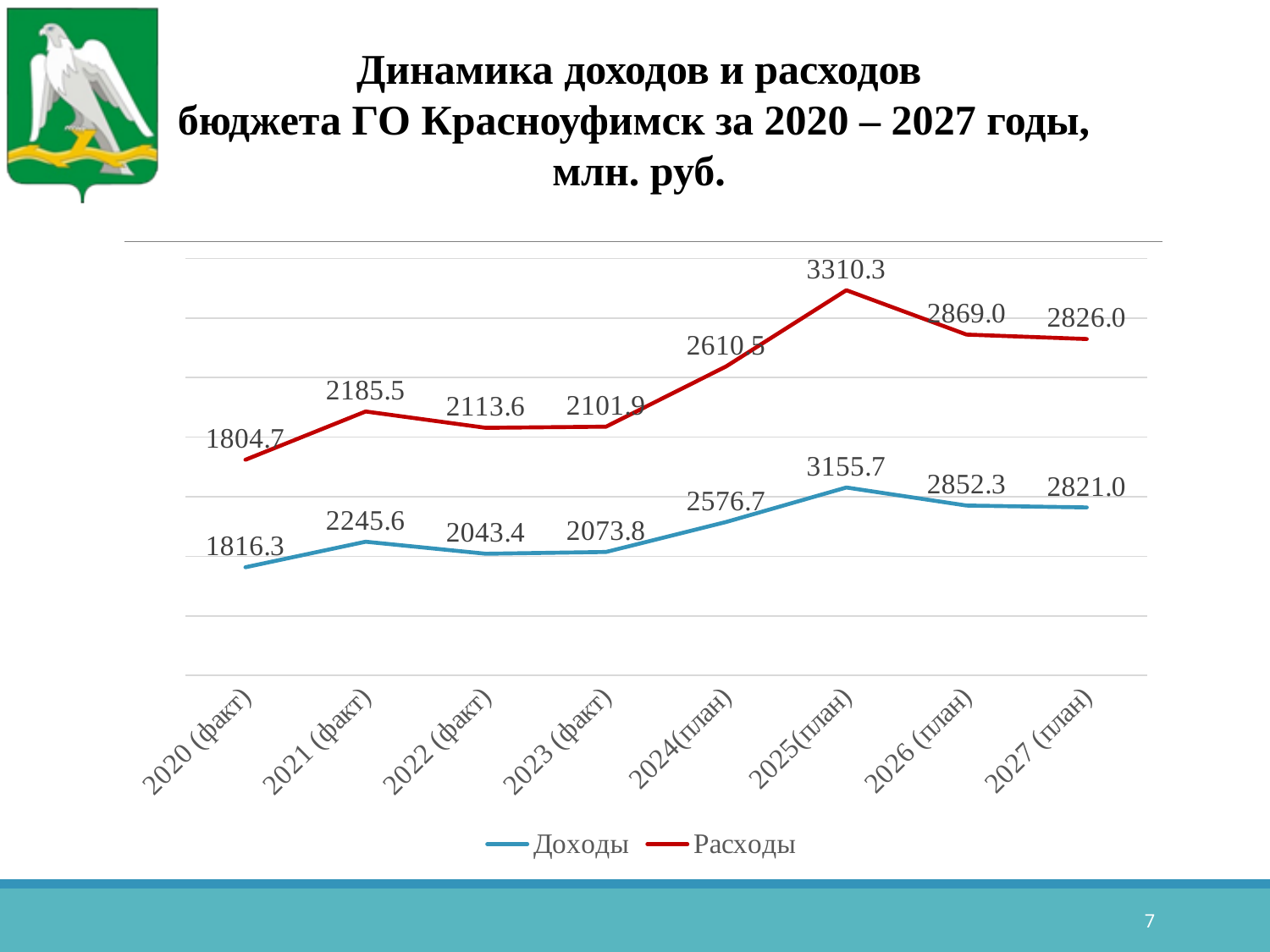
What type of chart is shown on the slide? line chart In which year is Доходы lowest? 2020 (факт) What is the value of Расходы for 2022 (факт)? 2113.6 Which series is drawn in red? Расходы How many series does the legend list? 2 How many categories (years) are plotted along the x axis? 8 Which is larger in 2021 (факт): Доходы or Расходы? Доходы What is the value of Расходы for 2025(план)? 3310.3 In which year is Расходы highest? 2025(план) What is the value of Доходы for 2027 (план)? 2821.0 What is the difference between Расходы and Доходы in 2025(план)? 154.6 What is the value of Доходы for 2020 (факт)? 1816.3